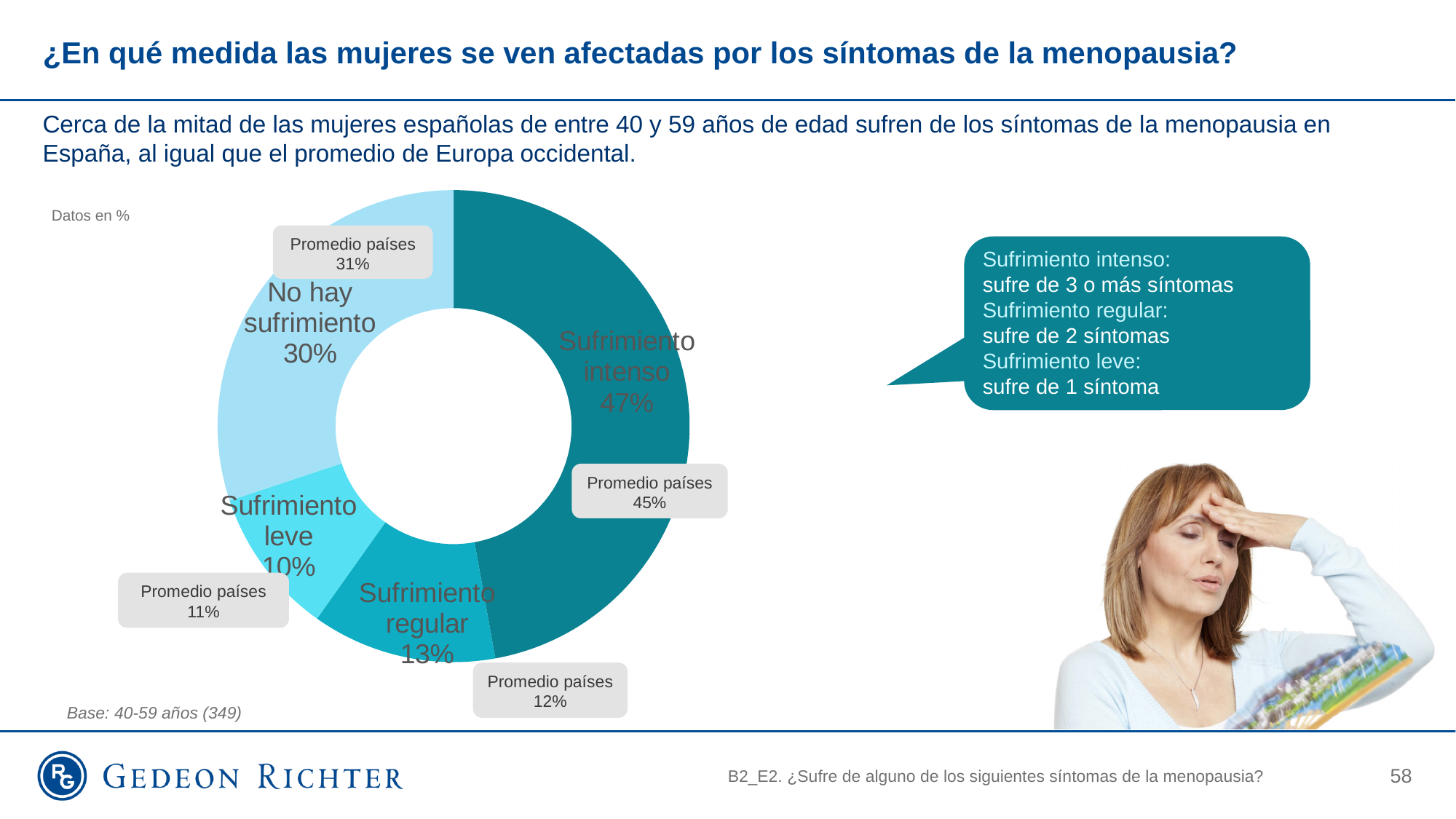
What value is shown for "No hay sufrimiento" in the donut chart? 30% Which slice of the donut chart is the smallest? Sufrimiento leve Which slice of the donut chart is the largest? Sufrimiento intenso What type of chart is shown on the slide? Donut (pie) chart What percentage of the donut chart is labelled "Sufrimiento intenso"? 47% Which is larger in the donut chart: "Sufrimiento regular" or "Sufrimiento leve"? Sufrimiento regular What is the base (sample size) stated below the chart? 40-59 años (349) How many slices does the donut chart have? 4 What is the "Promedio países" value shown next to the "Sufrimiento intenso" slice? 45% What is the "Promedio países" value shown next to the "Sufrimiento regular" slice? 12% What is the difference in percentage points between "Sufrimiento intenso" and "No hay sufrimiento"? 17 What value is shown for "Sufrimiento leve" in the donut chart? 10%